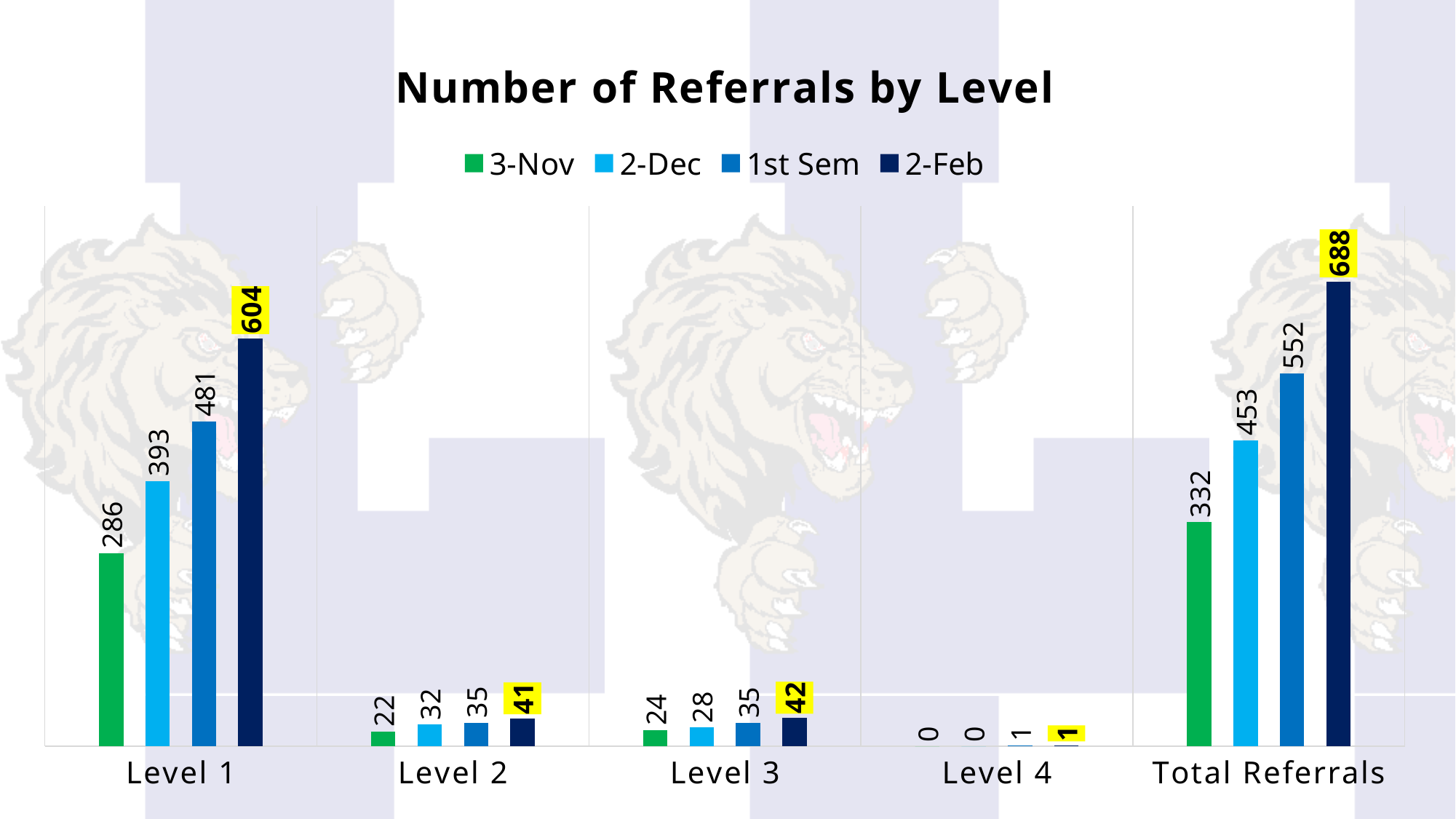
How many series does the legend list? 4 What is the value for 2-Feb at Level 1? 604 What is the value for 3-Nov at Total Referrals? 332 What is the difference between the 1st Sem and 2-Dec values at Total Referrals? 99 Which is larger: the 2-Feb value at Level 2 or the 2-Feb value at Level 3? Level 3 What type of chart is shown? Bar chart Which series has the highest value at Total Referrals? 2-Feb Which level has the lowest 2-Feb value? Level 4 What is the value for 2-Dec at Level 2? 32 What is the difference between the 2-Feb and 3-Nov values at Level 1? 318 How many categories are shown on the x axis? 5 What is the value for 1st Sem at Level 3? 35